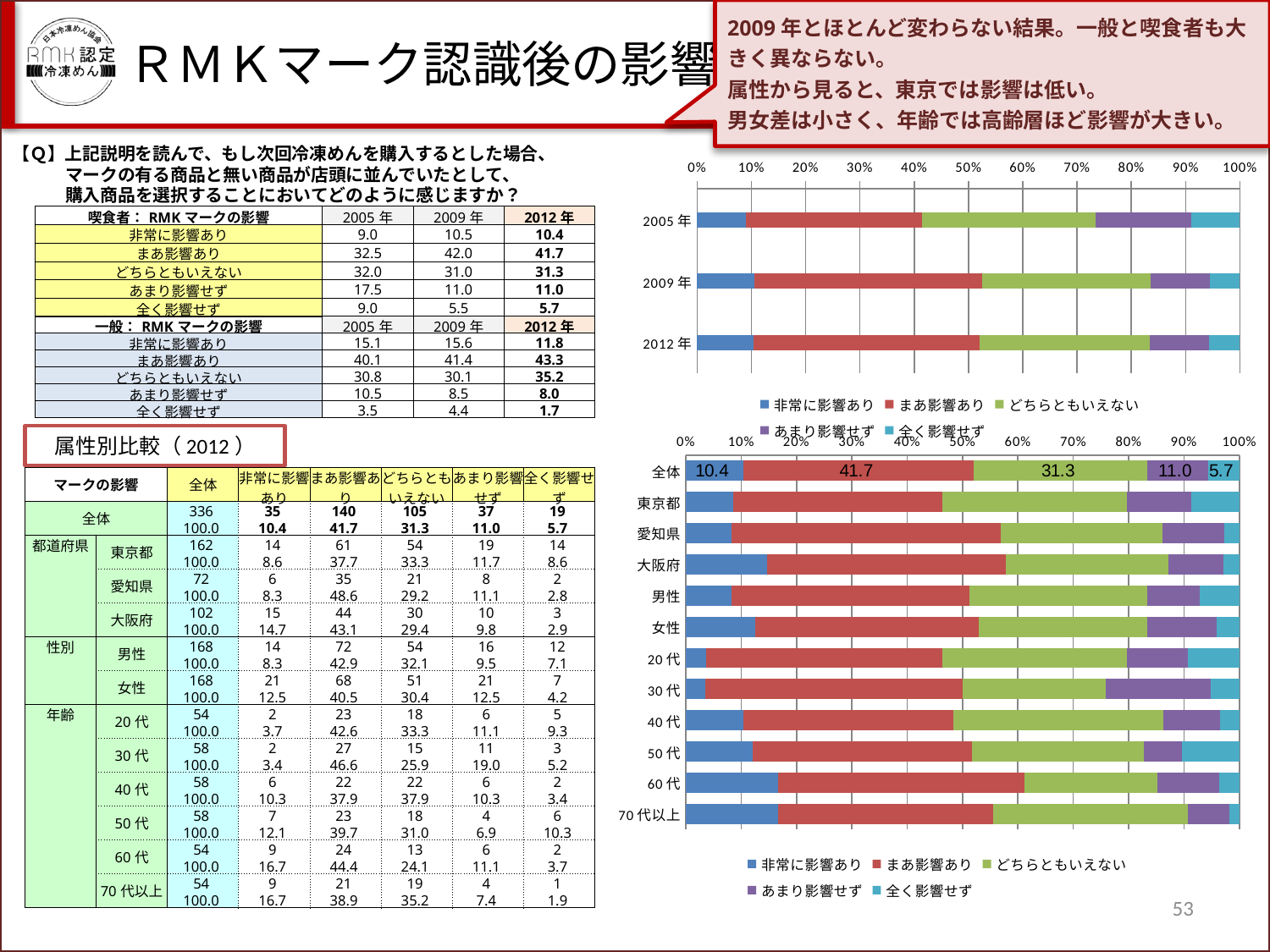
What kind of chart is the bottom-right chart (属性別比較 2012)? bar chart On the bottom-right chart, is the value of 非常に影響あり for 70代以上 greater or less than 10%? greater On the bottom-right chart, which has the larger 非常に影響あり segment, 70代以上 or 20代? 70代以上 On the bottom-right chart, is the value of 非常に影響あり for 20代 greater or less than 10%? less On the bottom-right chart, which segment of the 全体 bar is the largest? まあ影響あり How many categories are plotted on the bottom-right chart? 12 On the bottom-right chart, which segment of the 全体 bar is the smallest? 全く影響せず On the bottom-right chart, what is the value of まあ影響あり for 全体? 41.7 On the bottom-right chart, what is the value of 全く影響せず for 全体? 5.7 On the bottom-right chart, what is the value of 非常に影響あり for 全体? 10.4 How many series does the legend of the bottom-right chart list? 5 How many categories (years) are plotted on the top-right chart? 3